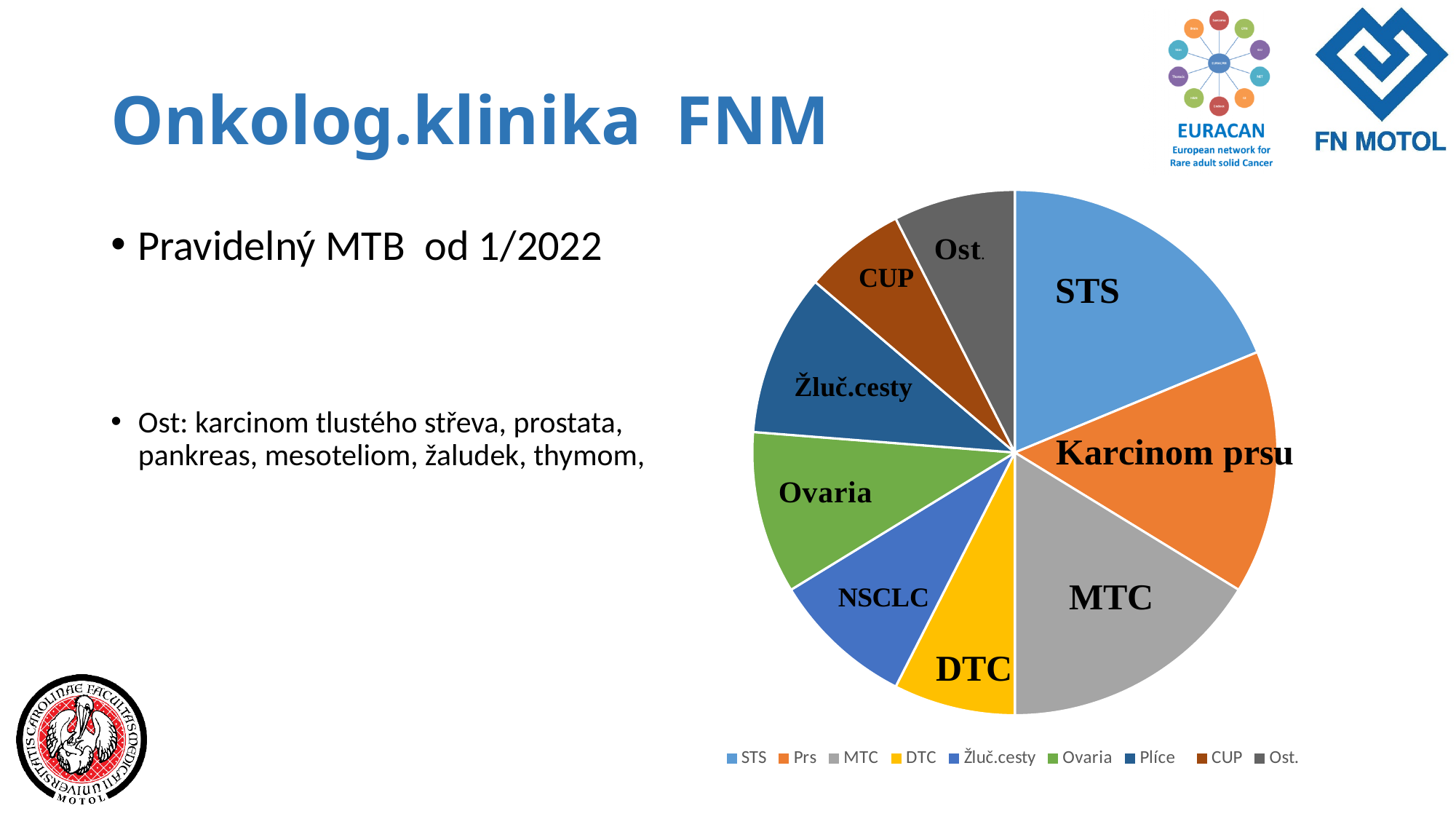
Which slice is larger in the pie chart, STS or CUP? STS Which slice is larger in the pie chart, MTC or DTC? MTC What colour is the STS slice in the pie chart? light blue What kind of chart is shown on the slide? pie chart Which slice is larger in the pie chart, Ovaria or Ost.? Ovaria How many entries does the legend of the pie chart list? 9 How many slices does the pie chart have? 9